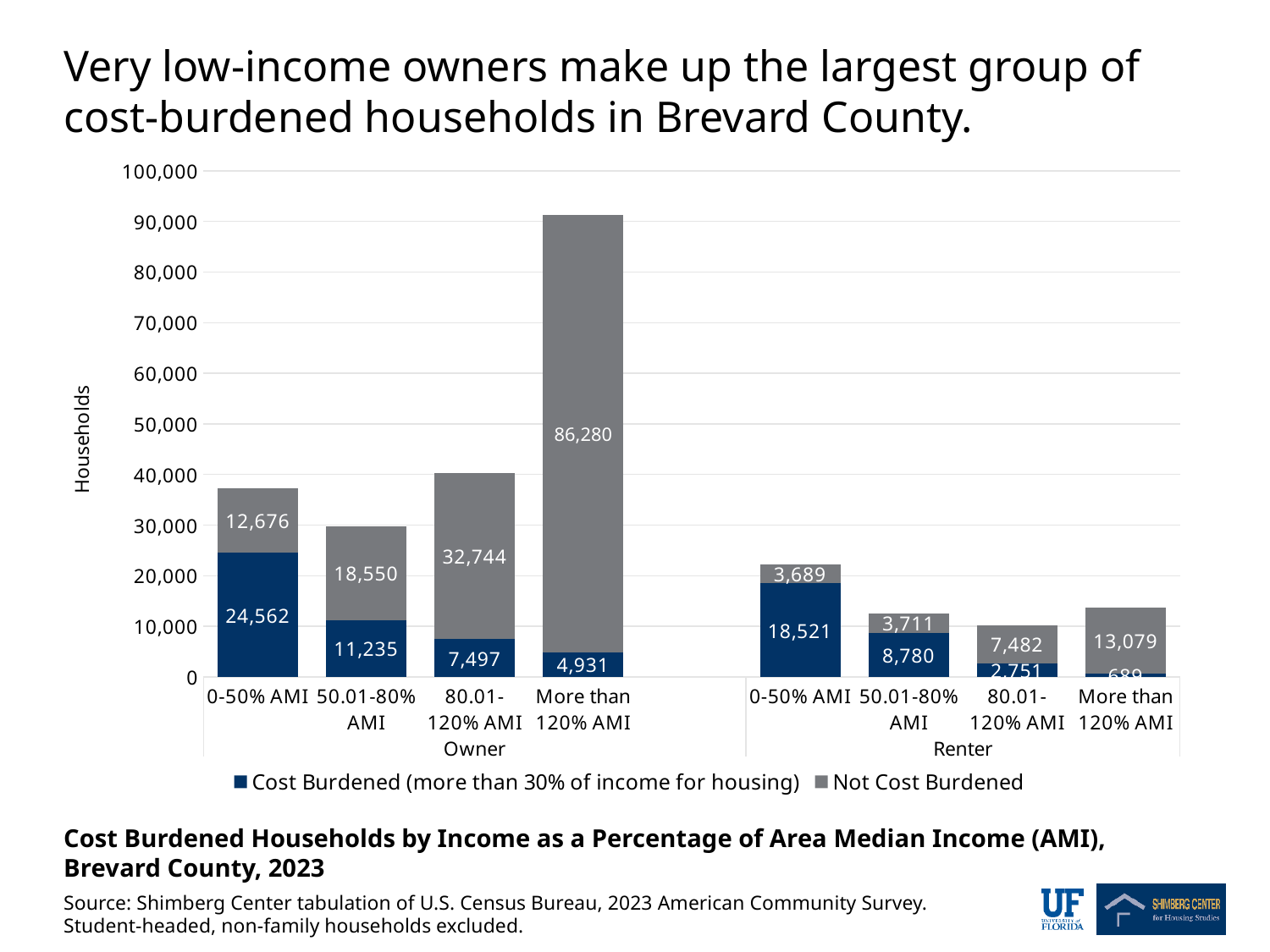
Which income group has the highest number of cost-burdened households across both owners and renters? Owner 0-50% AMI How many not-cost-burdened owner households are in the More than 120% AMI group? 86,280 Is the total height of the Owner More than 120% AMI bar greater or less than 90,000? greater What kind of chart is shown on the slide? Stacked bar chart Which is larger: not-cost-burdened owner households at 80.01-120% AMI or not-cost-burdened renter households at 80.01-120% AMI? Owner 80.01-120% AMI (32,744) How many cost-burdened owner households are in the 0-50% AMI group? 24,562 What is the total number of households in the Owner 0-50% AMI stacked bar? 37,238 How many cost-burdened renter households are in the 50.01-80% AMI group? 8,780 How many series does the legend list? 2 Which owner income group has the tallest stacked bar in total? More than 120% AMI What is the difference between cost-burdened owner households and cost-burdened renter households in the 0-50% AMI group? 6,041 How many income categories are shown for renters? 4